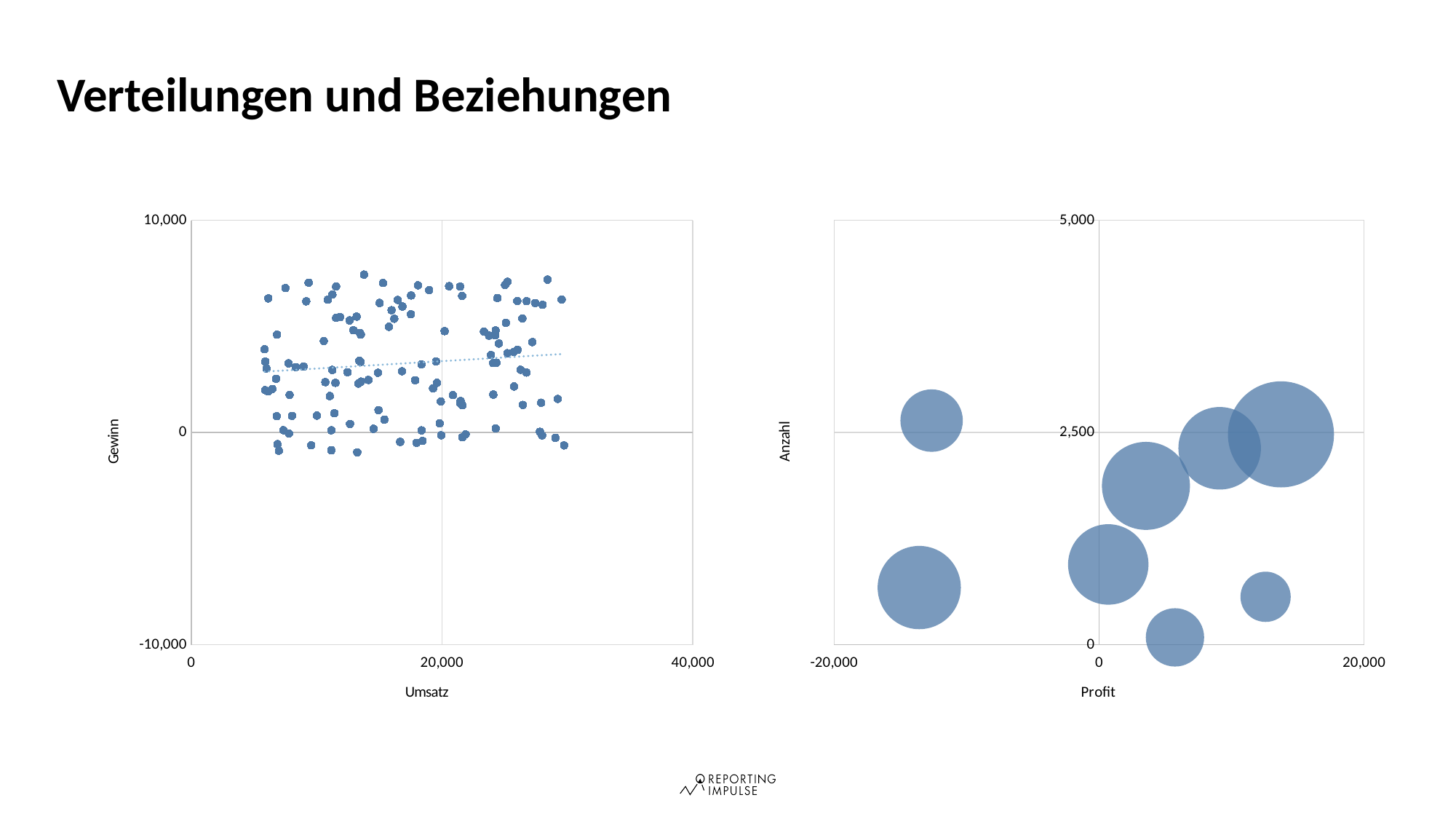
On the left chart, are all plotted points at an Umsatz less than 40,000? yes What is the label of the vertical axis on the left chart? Gewinn On the right chart, is the Profit value of the largest bubble greater or less than 0? greater On the right chart, is the Anzahl value of the smallest bubble greater or less than 2,500? less On the right chart, how many bubbles lie at a Profit less than 0? 2 On the left chart, does the dotted trend line rise or fall as Umsatz increases? rises What kind of chart is the right chart with the Profit axis? bubble chart What is the label of the horizontal axis on the right chart? Profit How many bubbles are plotted on the right chart? 8 What kind of chart is the left chart with the Umsatz axis? scatter chart